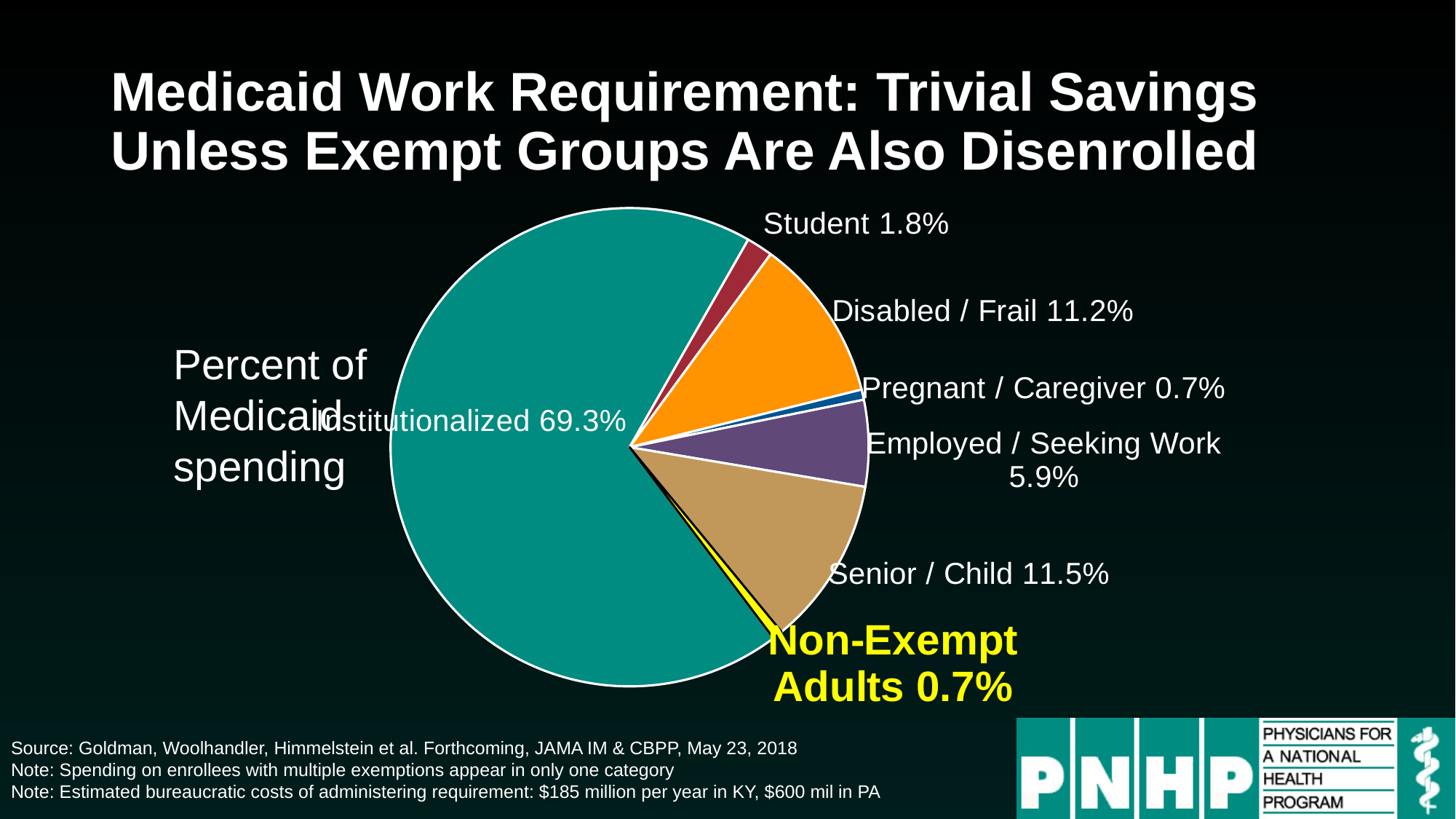
What is the difference in percentage points between Institutionalized and Senior / Child? 57.8 What is the value shown for Disabled / Frail? 11.2% What type of chart is shown on the slide? Pie chart What is the difference in percentage points between Disabled / Frail and Employed / Seeking Work? 5.3 Which is larger, the share for Senior / Child or the share for Disabled / Frail? Senior / Child What share of Medicaid spending goes to Non-Exempt Adults? 0.7% What is the value shown for Student? 1.8% Which category's label is highlighted in yellow on the chart? Non-Exempt Adults Which category accounts for the largest share of Medicaid spending? Institutionalized How many categories are shown in the pie chart? 7 What percentage of Medicaid spending is attributed to Institutionalized enrollees? 69.3% What is the value shown for Employed / Seeking Work? 5.9%